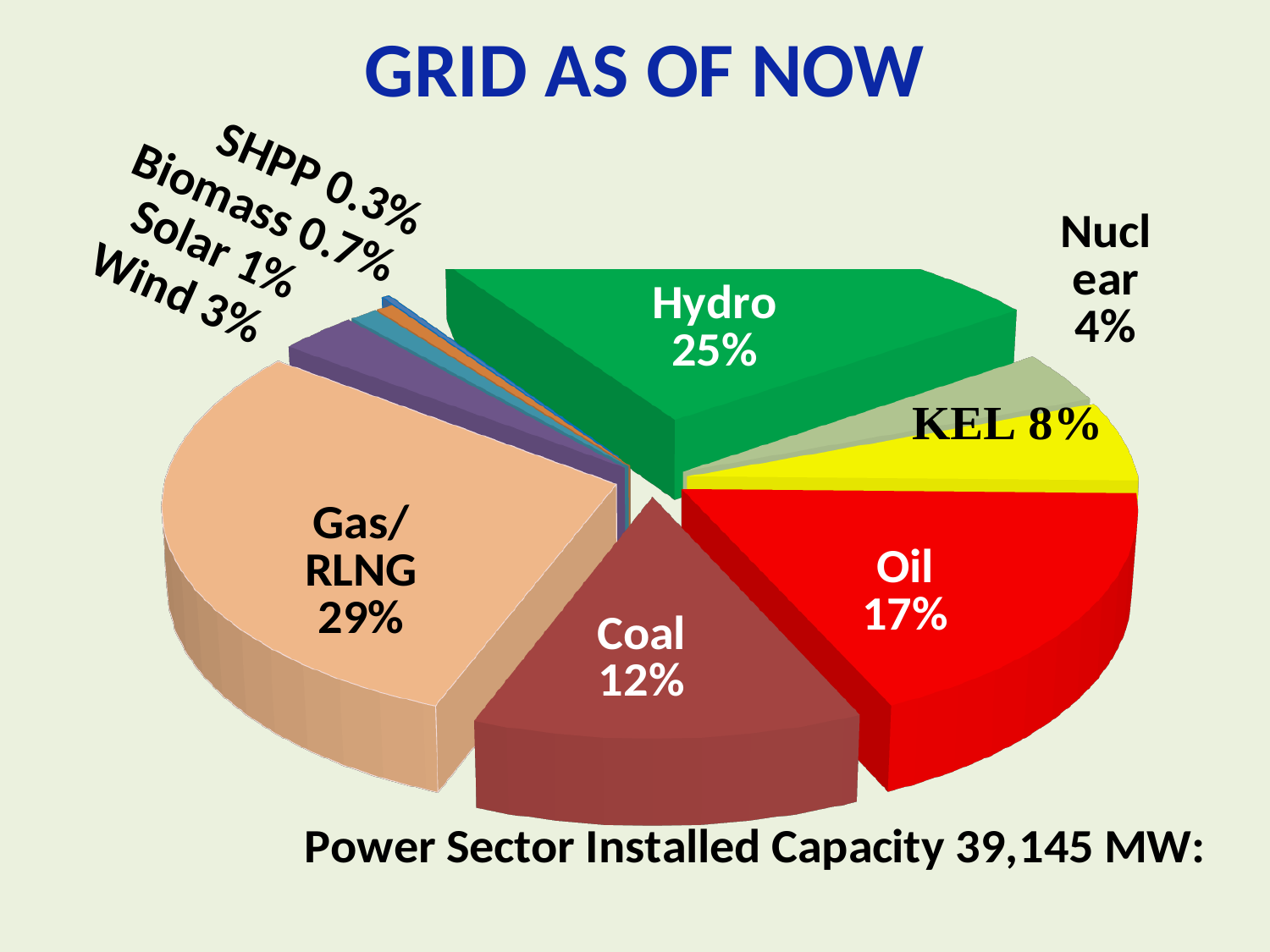
What kind of chart is shown on the slide? Pie chart What is the value shown for SHPP? 0.3% What percentage is shown for Coal? 12% What is the value shown for Gas/RLNG? 29% What is the title of the slide containing the pie chart? GRID AS OF NOW What total installed capacity is stated below the chart? 39,145 MW What is the difference in percentage points between Gas/RLNG and Hydro? 4 Which category has the smallest share of the pie? SHPP Which category has the largest share of the pie? Gas/RLNG What share of the pie does Hydro account for? 25% How many categories are shown in the pie chart? 10 Which is larger, the share for Oil or the share for Coal? Oil